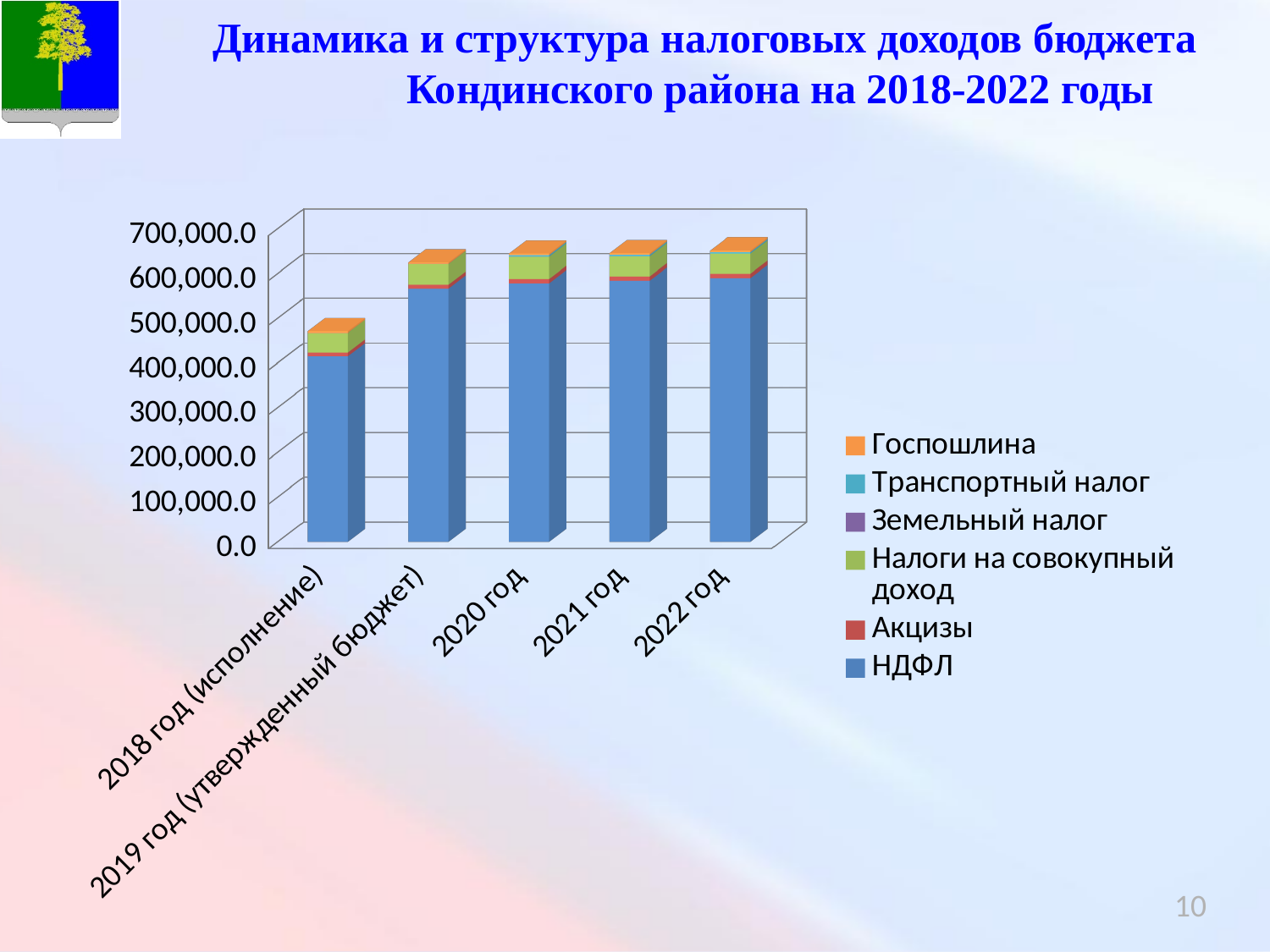
Which series is listed first in the chart legend? Госпошлина Is the НДФЛ segment for 2020 год greater or less than 500,000.0? greater Which series forms the largest (bottom) segment of every bar in the chart? НДФЛ Is the total bar for 2020 год greater or less than 600,000.0? greater Which category has the lowest total bar in the chart? 2018 год (исполнение) Is the total bar for 2022 год greater or less than 700,000.0? less Which is larger: the total bar for 2018 год (исполнение) or for 2019 год (утвержденный бюджет)? 2019 год (утвержденный бюджет) How many series does the chart legend list? 6 What kind of chart is shown on the slide? Stacked bar chart How many categories (years) are shown on the x axis of the chart? 5